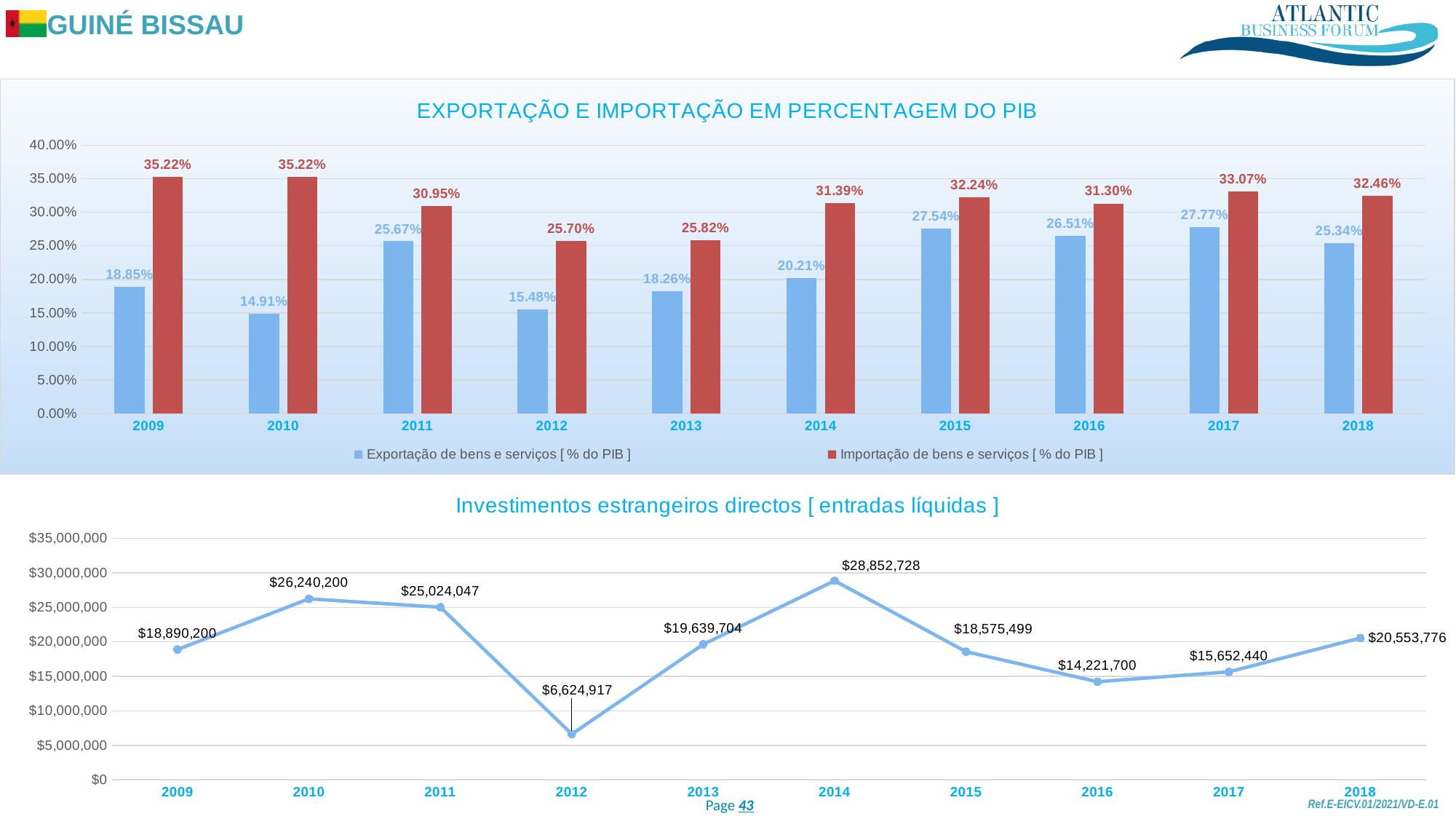
In the chart 'Investimentos estrangeiros directos [ entradas líquidas ]', what is the value for 2012? $6,624,917 What kind of chart is 'EXPORTAÇÃO E IMPORTAÇÃO EM PERCENTAGEM DO PIB'? Bar chart In the chart 'EXPORTAÇÃO E IMPORTAÇÃO EM PERCENTAGEM DO PIB', what is the difference between Importação and Exportação in 2018? 7.12 percentage points In the chart 'EXPORTAÇÃO E IMPORTAÇÃO EM PERCENTAGEM DO PIB', how many years are shown on the x axis? 10 In the chart 'EXPORTAÇÃO E IMPORTAÇÃO EM PERCENTAGEM DO PIB', what is the value of Importação de bens e serviços for 2017? 33.07% In the chart 'EXPORTAÇÃO E IMPORTAÇÃO EM PERCENTAGEM DO PIB', which year has the lowest value for Exportação de bens e serviços? 2010 In the chart 'EXPORTAÇÃO E IMPORTAÇÃO EM PERCENTAGEM DO PIB', what is the value of Exportação de bens e serviços for 2014? 20.21% In the chart 'Investimentos estrangeiros directos [ entradas líquidas ]', is the value for 2016 larger or smaller than the value for 2017? Smaller In the chart 'Investimentos estrangeiros directos [ entradas líquidas ]', what is the difference between the values for 2010 and 2009? $7,350,000 What kind of chart is 'Investimentos estrangeiros directos [ entradas líquidas ]'? Line chart In the chart 'Investimentos estrangeiros directos [ entradas líquidas ]', which year has the highest value? 2014 In the chart 'EXPORTAÇÃO E IMPORTAÇÃO EM PERCENTAGEM DO PIB', how many series does the legend list? 2